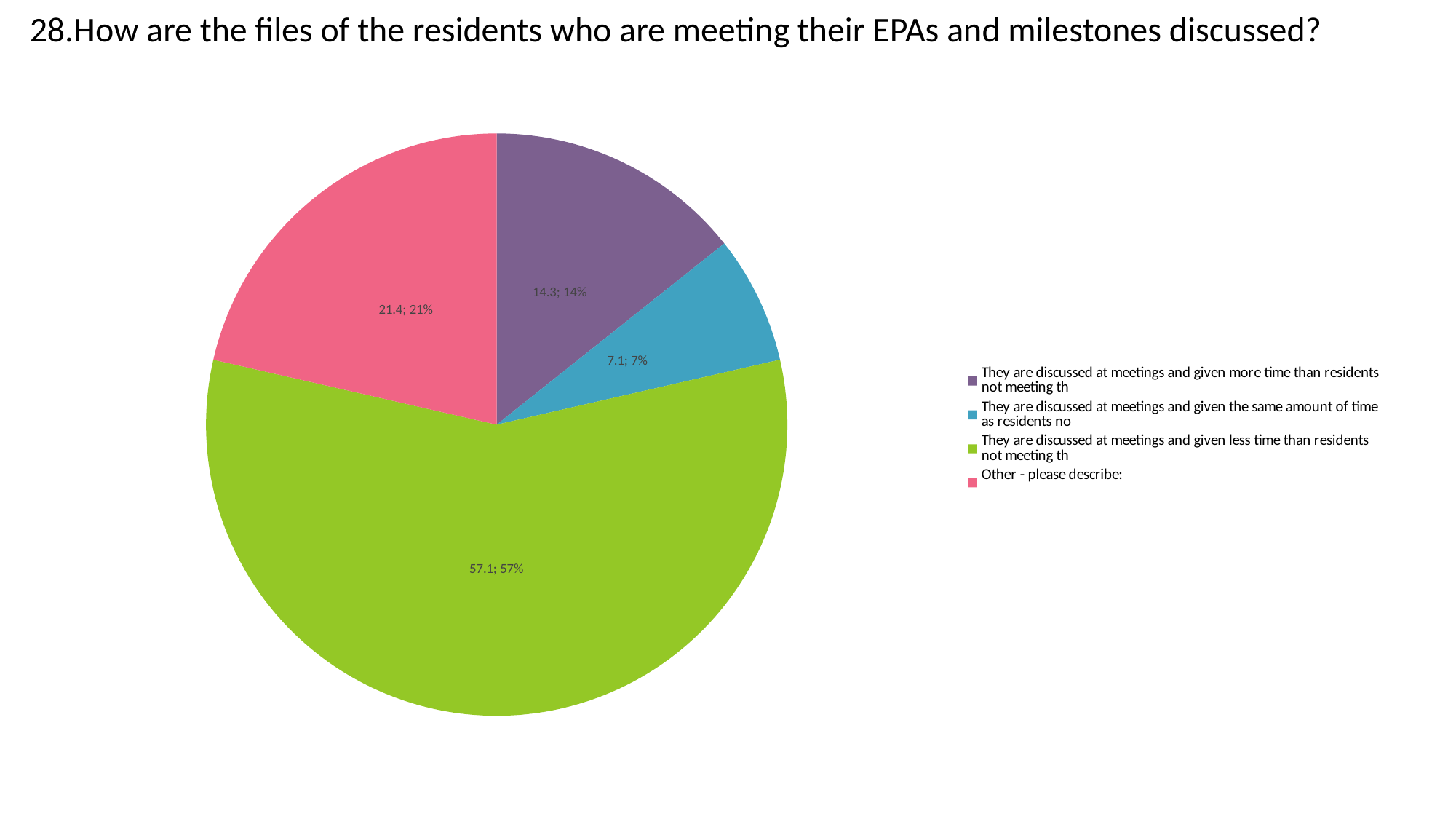
Which legend category has the smallest slice of the pie? They are discussed at meetings and given the same amount of time as residents no What value is labelled on the slice for 'They are discussed at meetings and given more time than residents not meeting th'? 14.3 What percentage share is labelled on the slice for 'They are discussed at meetings and given less time than residents not meeting th'? 57% What is the difference between the labelled values for the 'Other - please describe:' slice and the 'given more time' slice? 7.1 How many entries does the legend list? 4 What kind of chart is shown on the slide? pie chart Which legend category has the largest slice of the pie? They are discussed at meetings and given less time than residents not meeting th What colour is the slice for 'Other - please describe:'? pink What value is labelled on the slice for 'They are discussed at meetings and given the same amount of time as residents no'? 7.1 How many slices does the pie chart have? 4 Which slice is larger: 'Other - please describe:' or 'They are discussed at meetings and given more time than residents not meeting th'? Other - please describe: What percentage share is labelled on the 'Other - please describe:' slice? 21%